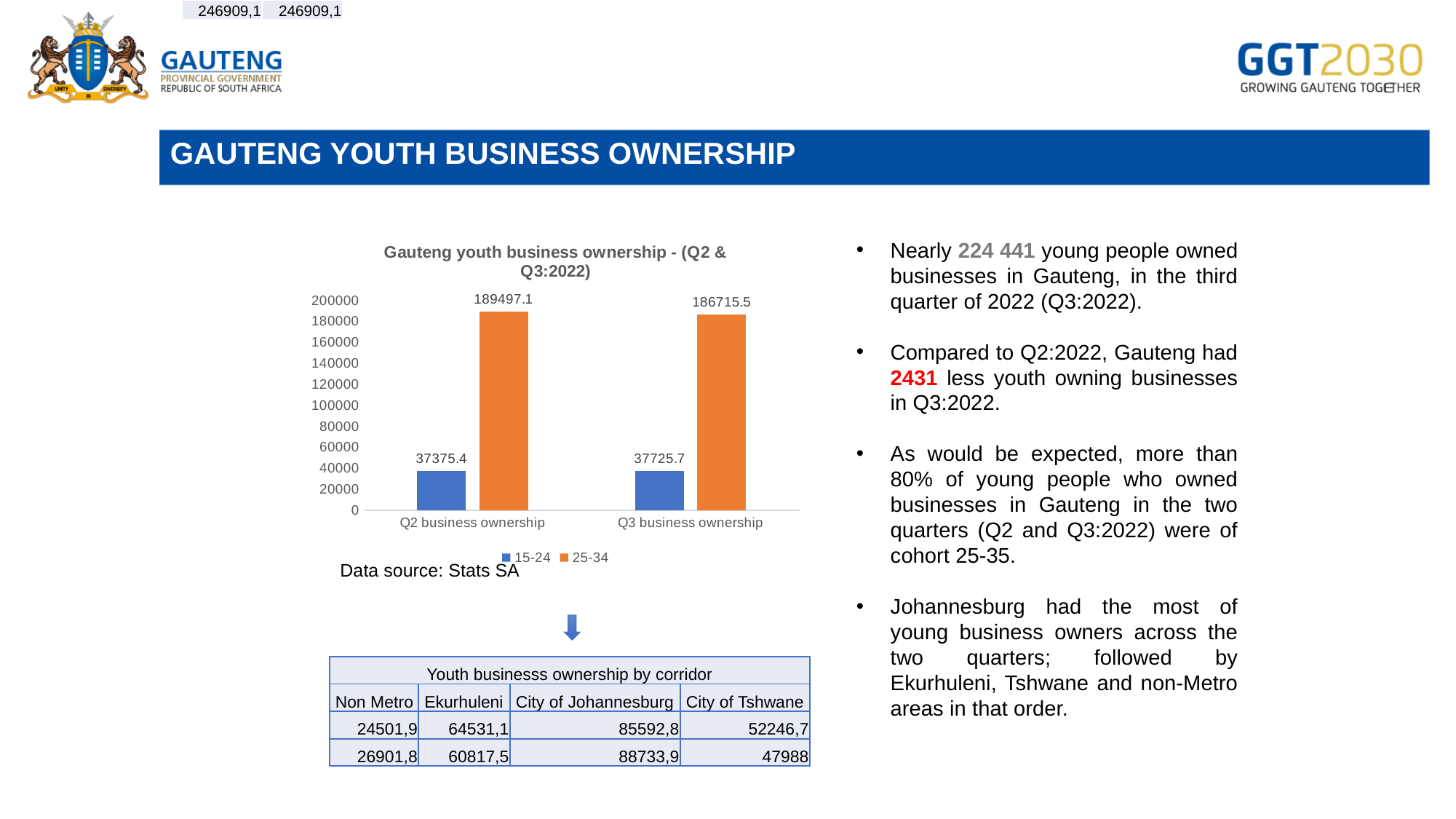
What is the value for the 15-24 series in Q2 business ownership? 37375.4 What is the value for the 15-24 series in Q3 business ownership? 37725.7 How many categories are shown on the x axis of the chart? 2 Which is larger, the 15-24 value in Q2 business ownership or in Q3 business ownership? Q3 business ownership Which bar has the highest value in the chart? 25-34 in Q2 business ownership What is the difference between the 25-34 values for Q2 and Q3 business ownership? 2781.6 Which bar has the lowest value in the chart? 15-24 in Q2 business ownership What is the value for the 25-34 series in Q3 business ownership? 186715.5 What is the value for the 25-34 series in Q2 business ownership? 189497.1 What is the difference between the 25-34 and 15-24 values in Q2 business ownership? 152121.7 What kind of chart is shown on the slide? Bar chart How many series does the chart legend list? 2